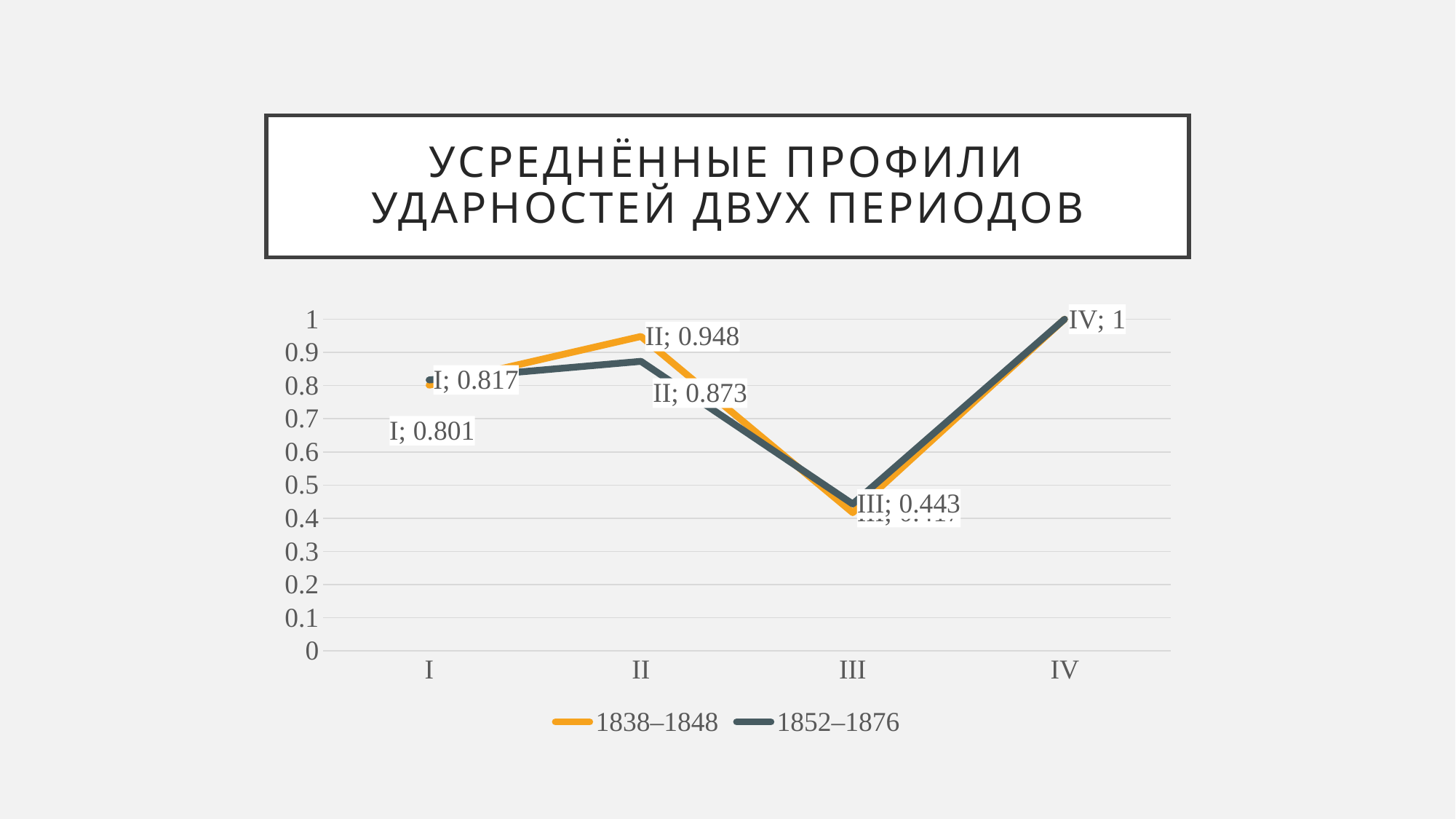
What is the value at category IV? 1 Is the value for the 1838–1848 series at category III greater or less than 0.5? less How many series does the legend list? 2 What is the value for the 1852–1876 series at category I? 0.817 What is the value for the 1838–1848 series at category II? 0.948 What is the value for the 1852–1876 series at category III? 0.443 How many categories are on the x axis? 4 Which category has the lowest value for the 1852–1876 series? III What is the value for the 1852–1876 series at category II? 0.873 Which category has the highest value for the 1838–1848 series? IV What is the difference between the 1838–1848 and 1852–1876 values at category II? 0.075 What type of chart is shown on the slide? line chart